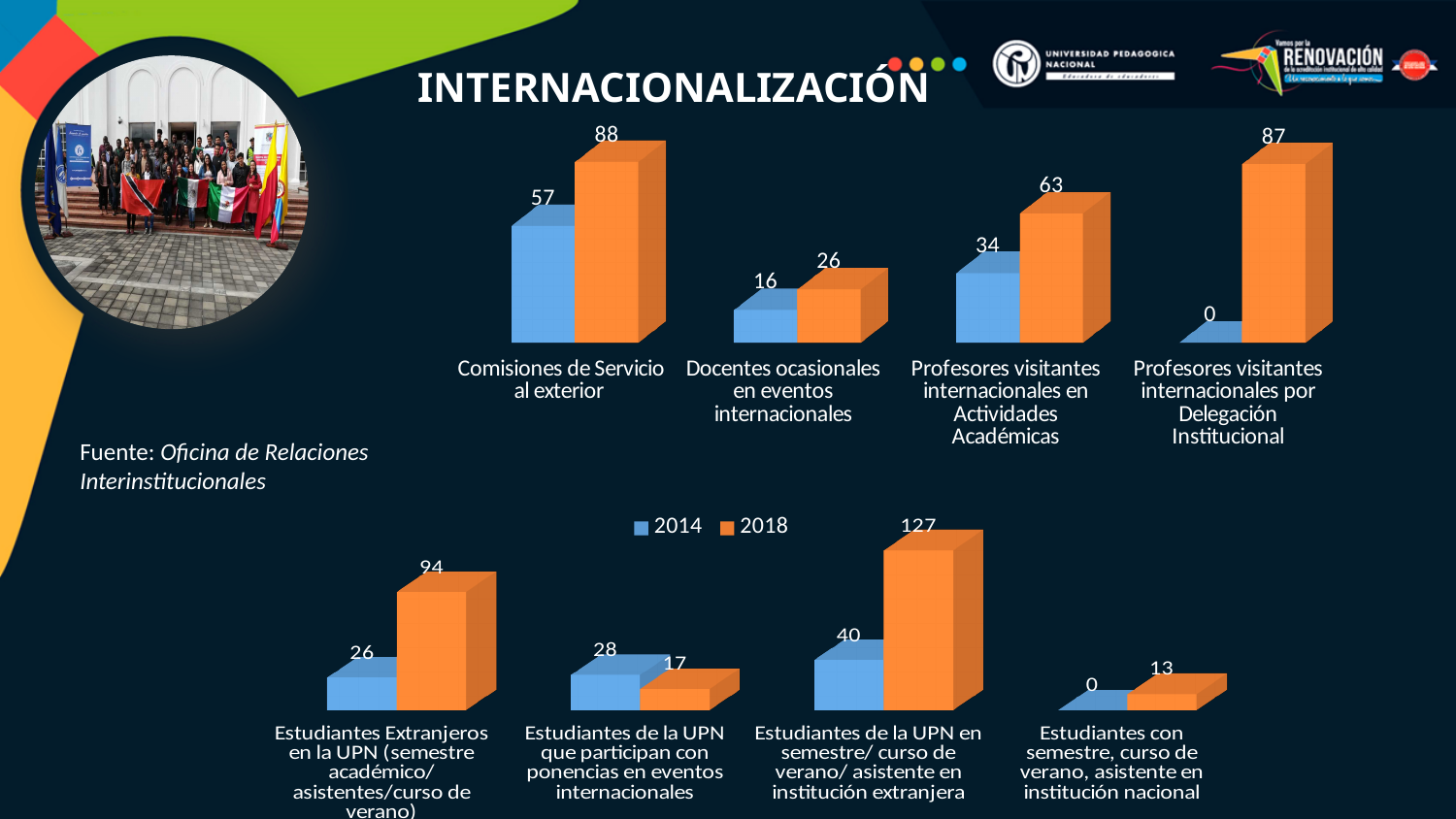
In the top chart, which category has the highest orange bar? Comisiones de Servicio al exterior How many categories are shown in the top chart? 4 In the bottom chart, which category has the lowest 2018 value? Estudiantes con semestre, curso de verano, asistente en institución nacional In the top chart, what is the value of the orange bar for 'Comisiones de Servicio al exterior'? 88 In the bottom chart, what is the difference between the 2018 and 2014 values for 'Estudiantes Extranjeros en la UPN'? 68 How many series does the legend on the slide list? 2 What type of chart is the bottom chart? Bar chart In the bottom chart, what is the 2018 value for 'Estudiantes de la UPN en semestre/ curso de verano/ asistente en institución extranjera'? 127 In the top chart, what is the difference between the orange and blue bars for 'Profesores visitantes internacionales en Actividades Académicas'? 29 In the top chart, which category has a blue bar value of 0? Profesores visitantes internacionales por Delegación Institucional In the top chart, what is the value of the blue bar for 'Docentes ocasionales en eventos internacionales'? 16 In the bottom chart, is the 2014 value or the 2018 value larger for 'Estudiantes de la UPN que participan con ponencias en eventos internacionales'? 2014